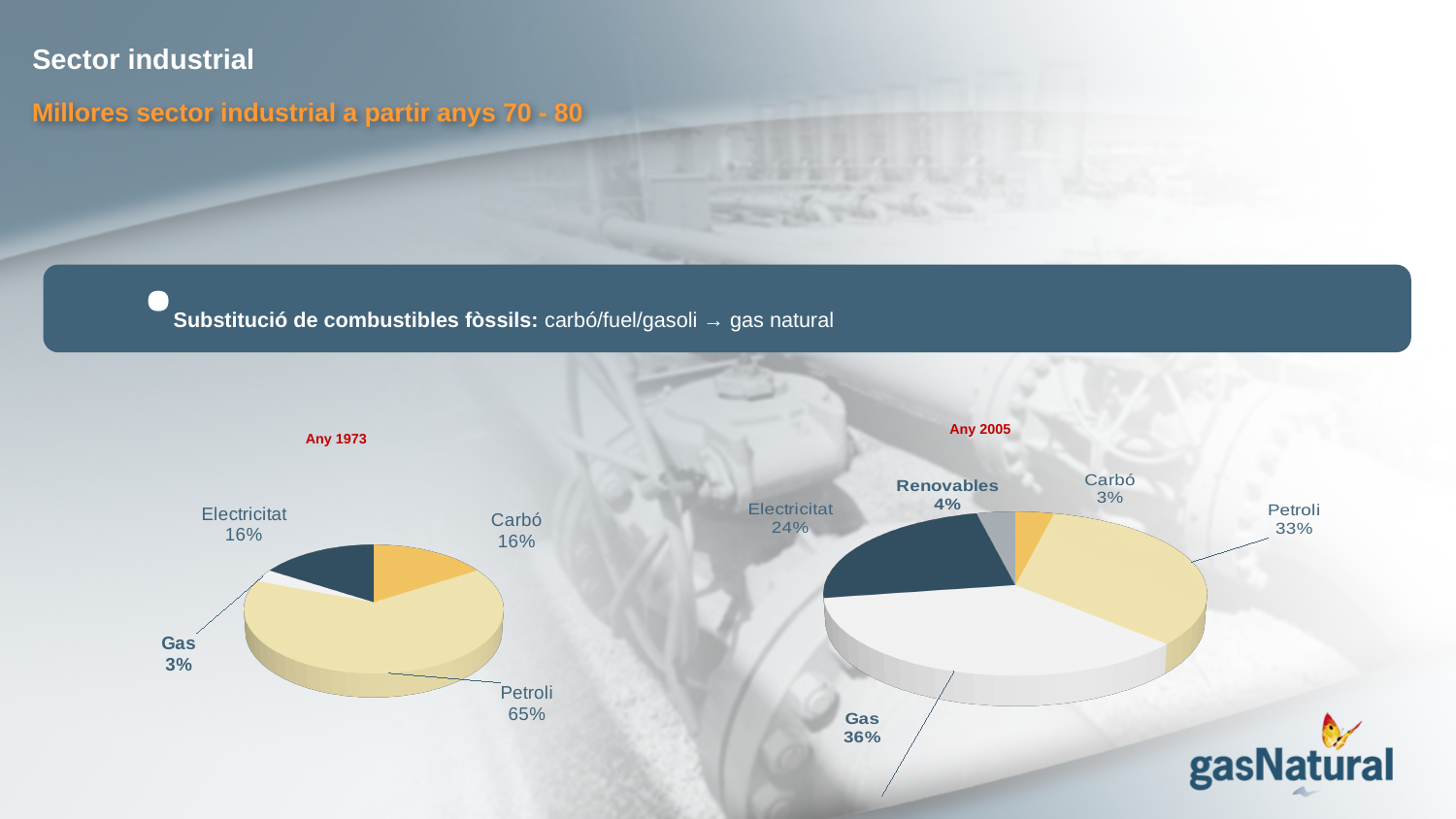
In the 'Any 2005' chart, which category has the largest share? Gas In the 'Any 2005' chart, what share does Gas have? 36% What type of chart is the 'Any 1973' chart? Pie chart In the 'Any 2005' chart, what share does Renovables have? 4% In the 'Any 2005' chart, which category has the smallest share? Carbó In the 'Any 1973' chart, how many slices does the pie have? 4 In the 'Any 1973' chart, what share does Gas have? 3% What is the difference between the Gas share in the 'Any 2005' chart and the Gas share in the 'Any 1973' chart? 33% In the 'Any 1973' chart, what share does Petroli have? 65% In the 'Any 1973' chart, which category has the smallest share? Gas In the 'Any 2005' chart, how many slices does the pie have? 5 In the 'Any 1973' chart, which category has the largest share? Petroli